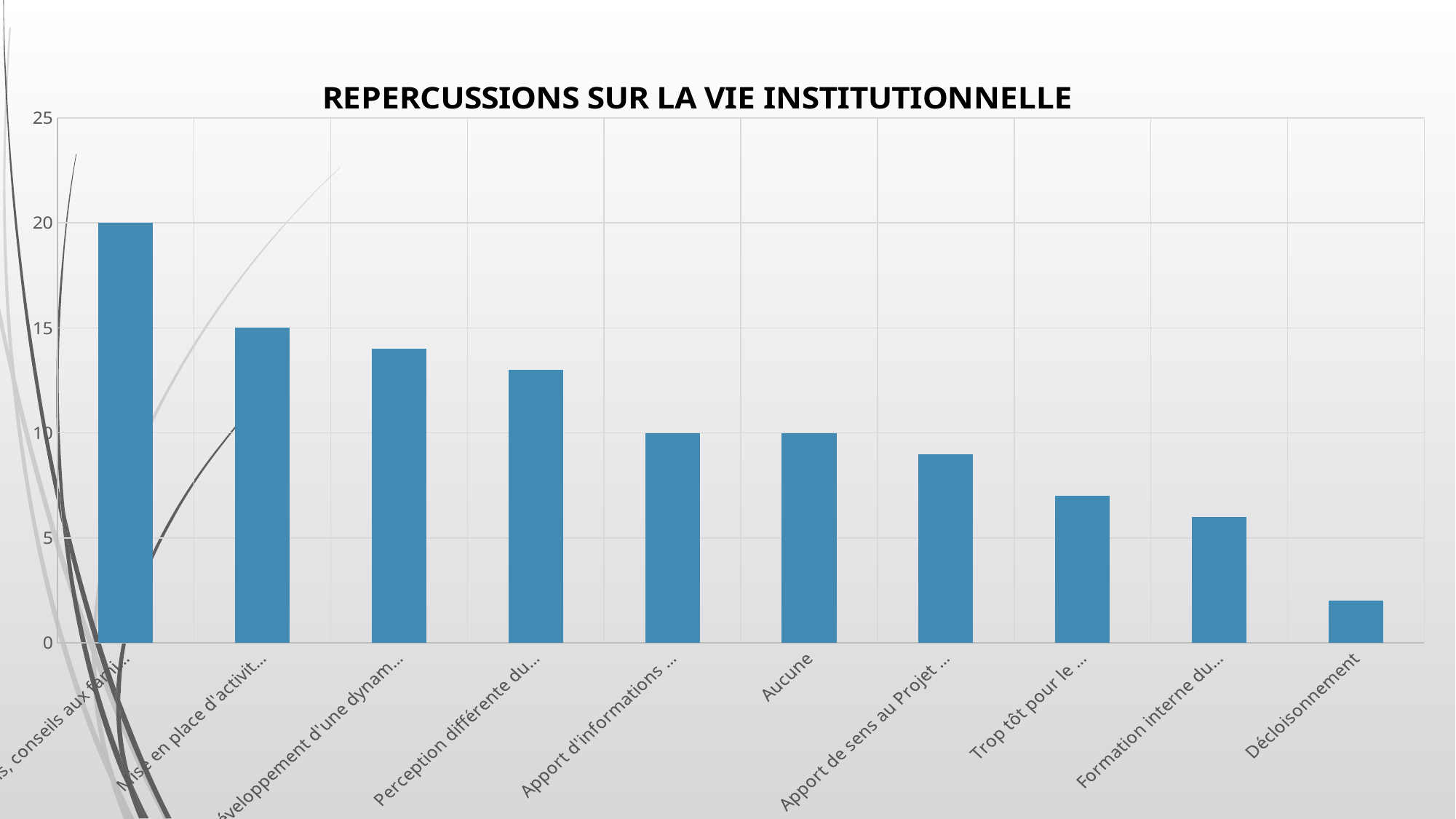
What is the value of the bar for 'Aucune'? 10 Is the value for 'Trop tôt pour le ...' greater or less than 10? less How many bars are plotted in the chart? 10 What is the title of the chart? REPERCUSSIONS SUR LA VIE INSTITUTIONNELLE What is the value of the bar for 'Mise en place d'activit...'? 15 Is the value for 'Perception différente du...' greater or less than 10? greater What is the difference between the values for 'Mise en place d'activit...' and 'Aucune'? 5 Which category has the lowest value in the chart? Décloisonnement What is the value of the leftmost bar in the chart? 20 Is the value for 'Décloisonnement' greater or less than 5? less What type of chart is shown on the slide? bar chart Do the bar values rise or fall from left to right across the chart? fall